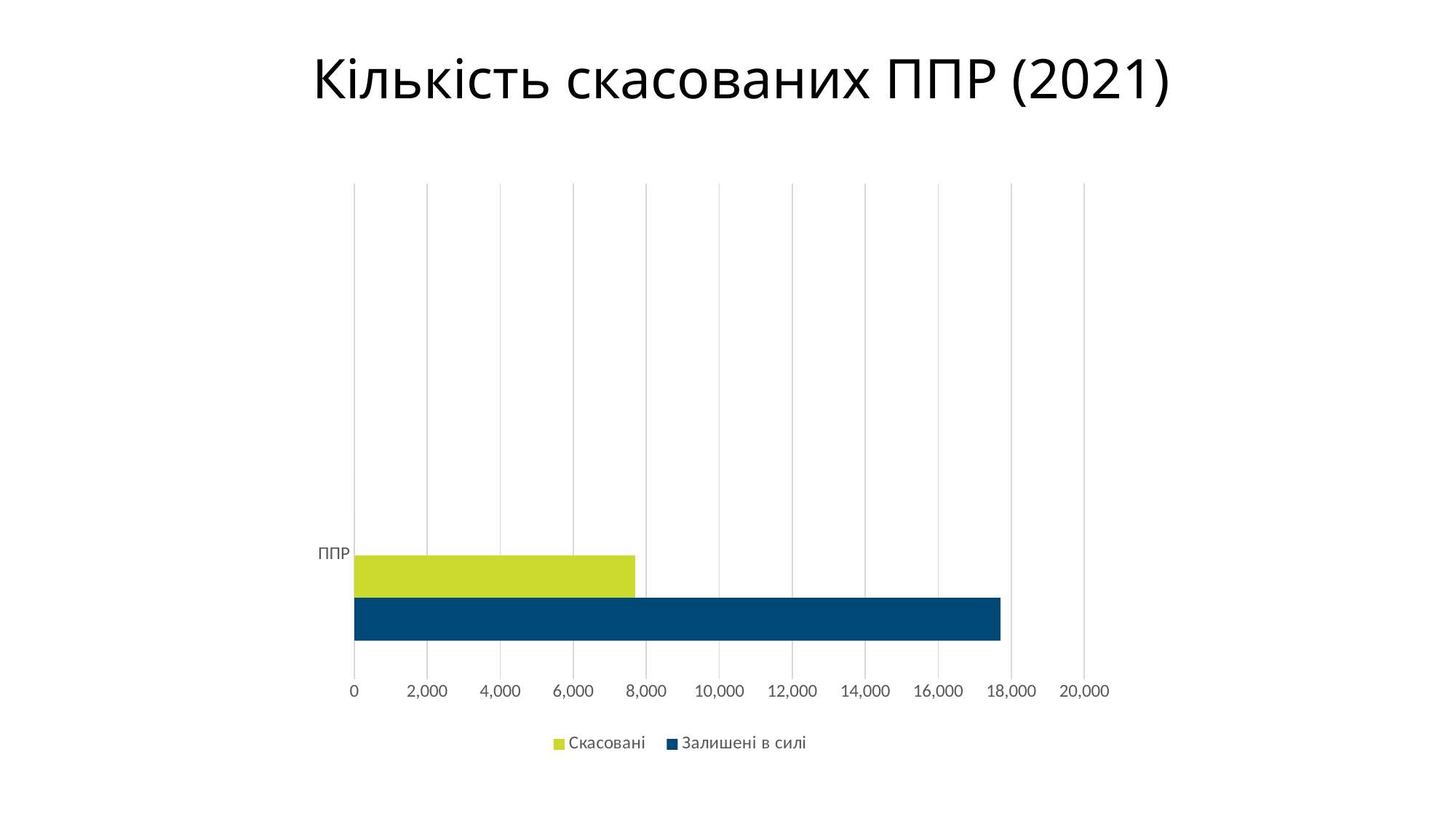
How many categories are shown on the vertical axis? 1 What is the title of the chart? Кількість скасованих ППР (2021) Is the value for Скасовані greater or less than 6,000? greater What is the highest value shown on the horizontal axis? 20,000 Is the value for Залишені в силі greater or less than 16,000? greater Which series has the smaller value for ППР? Скасовані Is the value for Залишені в силі greater or less than 18,000? less Which series has the larger value for ППР: Скасовані or Залишені в силі? Залишені в силі How many series does the legend list? 2 What kind of chart is shown on the slide? bar chart Which series is shown in green? Скасовані